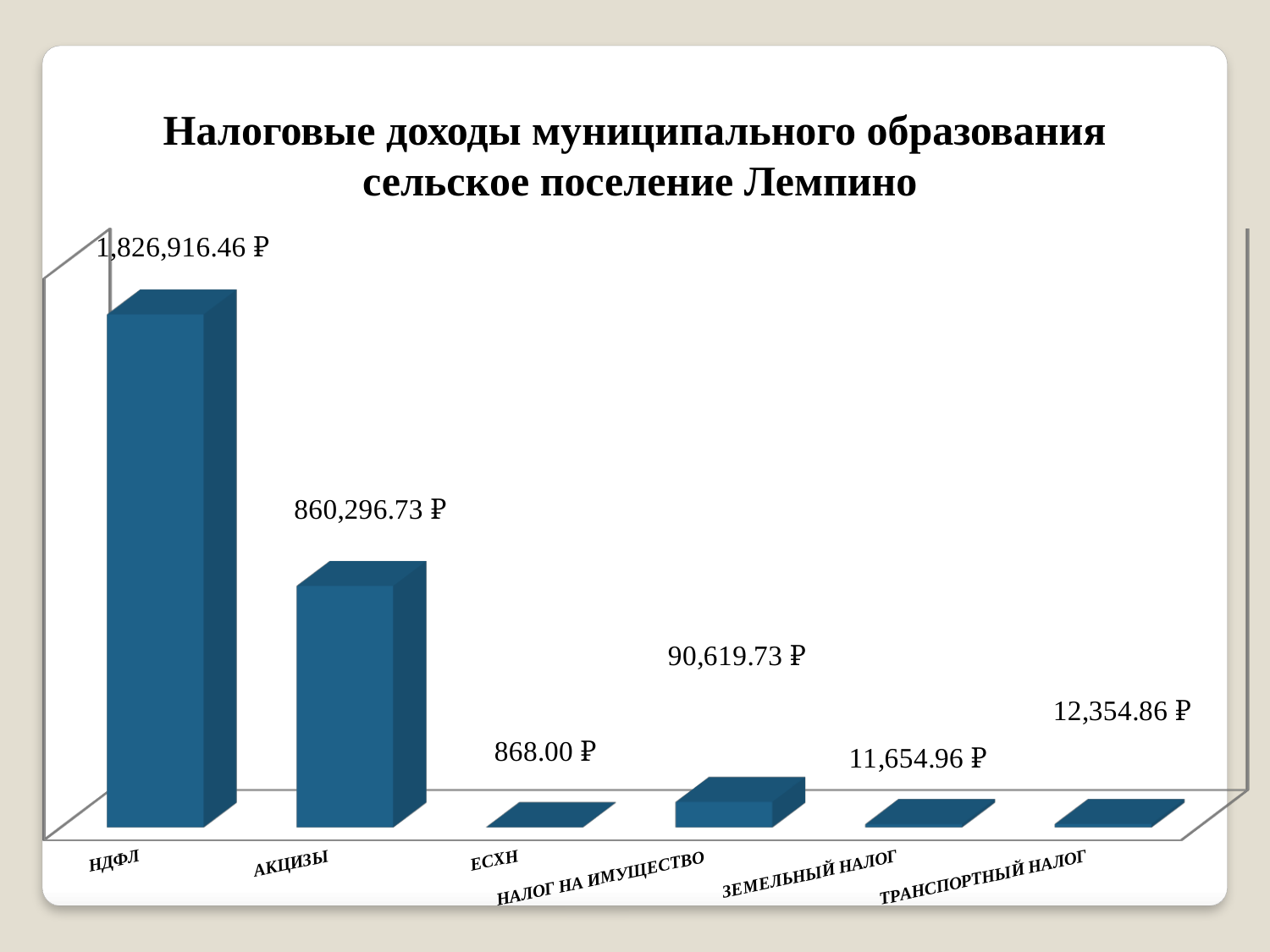
How many categories are shown in the chart? 6 What is the value for ЕСХН? 868.00 ₽ What is the difference between the values for ТРАНСПОРТНЫЙ НАЛОГ and ЗЕМЕЛЬНЫЙ НАЛОГ? 699.90 ₽ What is the value for АКЦИЗЫ? 860,296.73 ₽ What kind of chart is shown on the slide? Bar chart What is the value for НДФЛ? 1,826,916.46 ₽ What is the difference between the values for НДФЛ and АКЦИЗЫ? 966,619.73 ₽ What is the value for НАЛОГ НА ИМУЩЕСТВО? 90,619.73 ₽ Which category has the highest value? НДФЛ Which is larger, the value for ТРАНСПОРТНЫЙ НАЛОГ or the value for ЗЕМЕЛЬНЫЙ НАЛОГ? ТРАНСПОРТНЫЙ НАЛОГ Which category has the lowest value? ЕСХН What is the value for ТРАНСПОРТНЫЙ НАЛОГ? 12,354.86 ₽